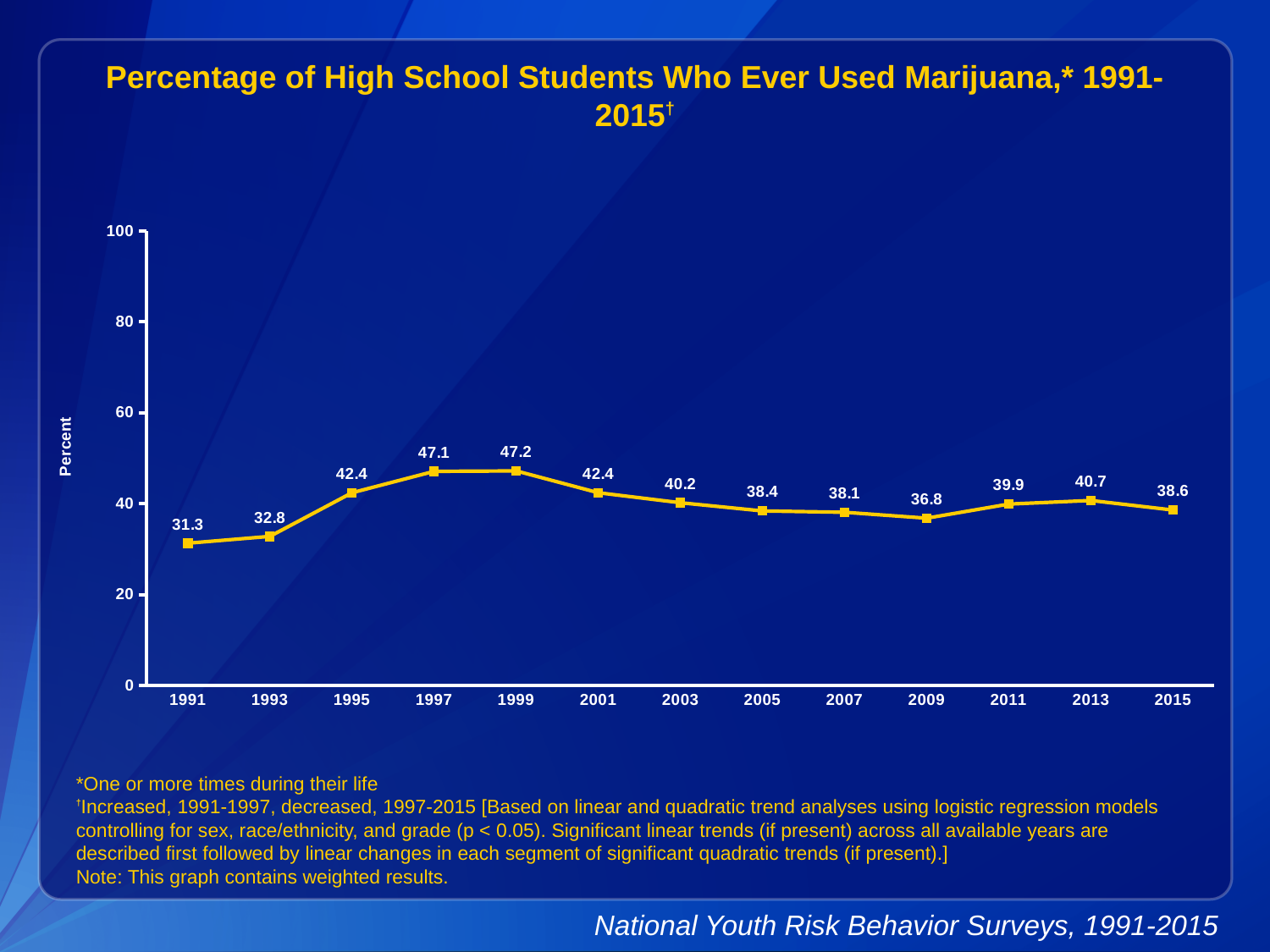
What is the difference between the values for 2013 and 2009? 3.9 What is the value for 2015? 38.6 How many years are plotted on the chart? 13 Is the value for 1997 greater or less than 40? greater What is the value for 1991? 31.3 What kind of chart is shown? line chart Do the values rise or fall from 1991 to 1997? rise What is the value for 2009? 36.8 What is the difference between the values for 1999 and 1991? 15.9 Which year has the lowest value? 1991 Which year has the highest value? 1999 Which is larger, the value for 1995 or the value for 2003? 1995